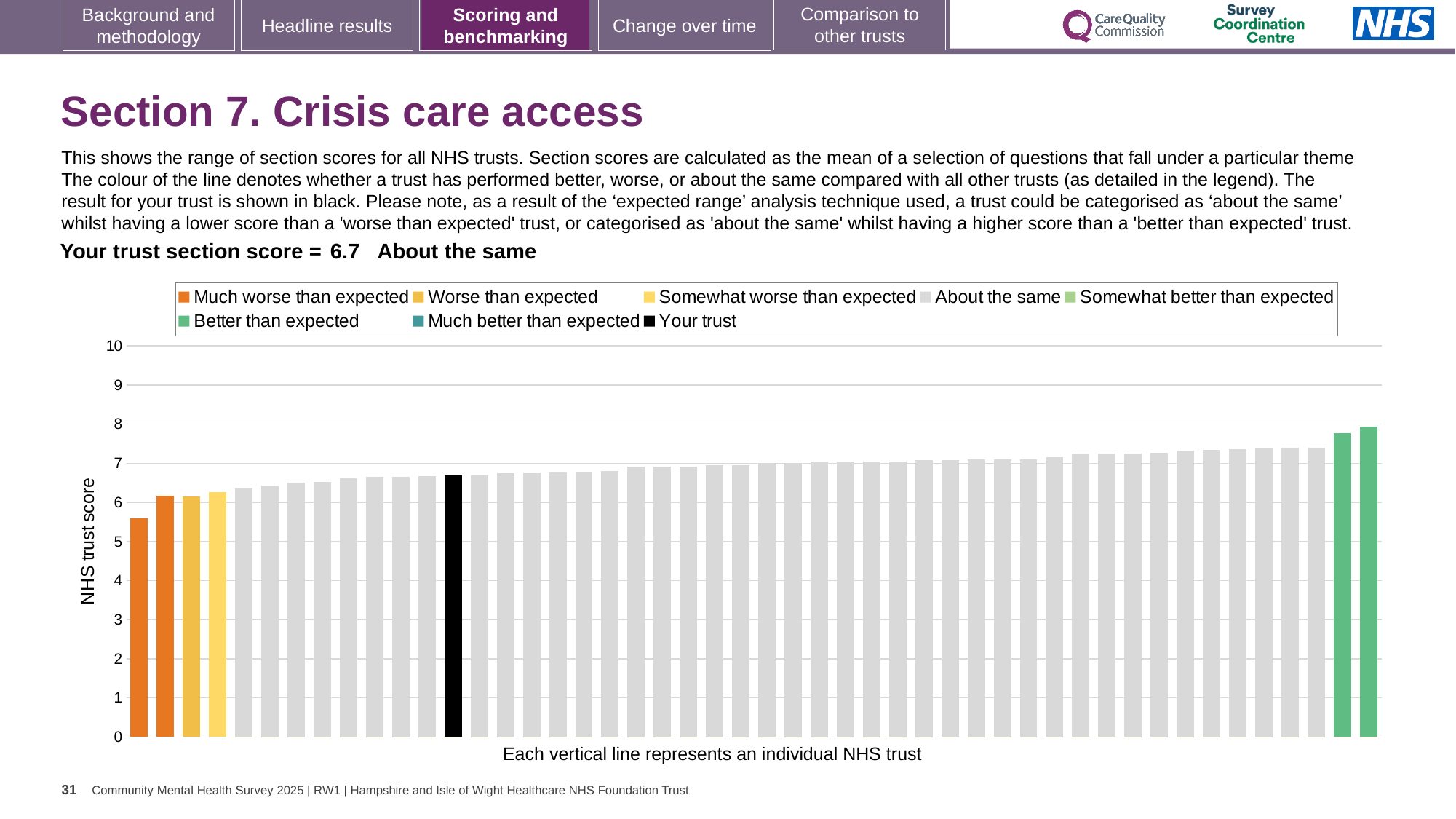
How many bars are coloured as 'Much worse than expected'? 2 What is the label of the vertical axis? NHS trust score Is the value of the highest bar in the chart greater or less than 7? greater How many entries does the chart legend list? 8 What is the section score for your trust shown on the slide? 6.7 Do the bar values rise or fall from left to right along the x axis? rise Is the value of the lowest bar in the chart greater or less than 6? less What kind of chart is shown on the slide? bar chart Is the value of the black bar (your trust) greater or less than 7? less How many bars are coloured as 'Better than expected'? 2 Which legend category is the black bar in the chart? Your trust